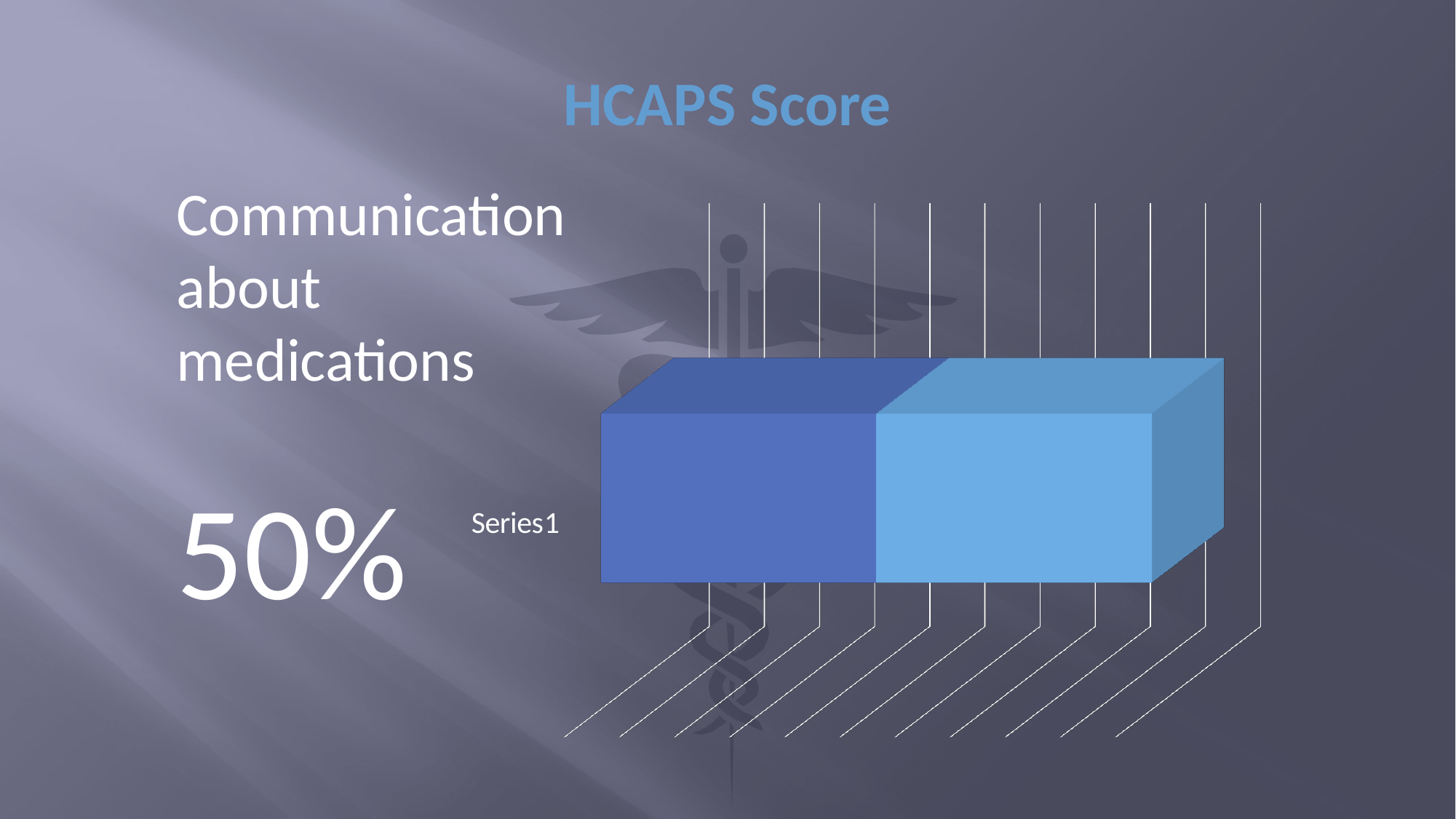
What is the title shown above the chart? HCAPS Score What is the label of the single category shown on the chart? Series1 How many coloured segments make up the bar for Series1? 2 What kind of chart is shown on the slide? bar chart Which colour is the left segment of the Series1 bar? dark blue How many categories are plotted on the chart's category axis? 1